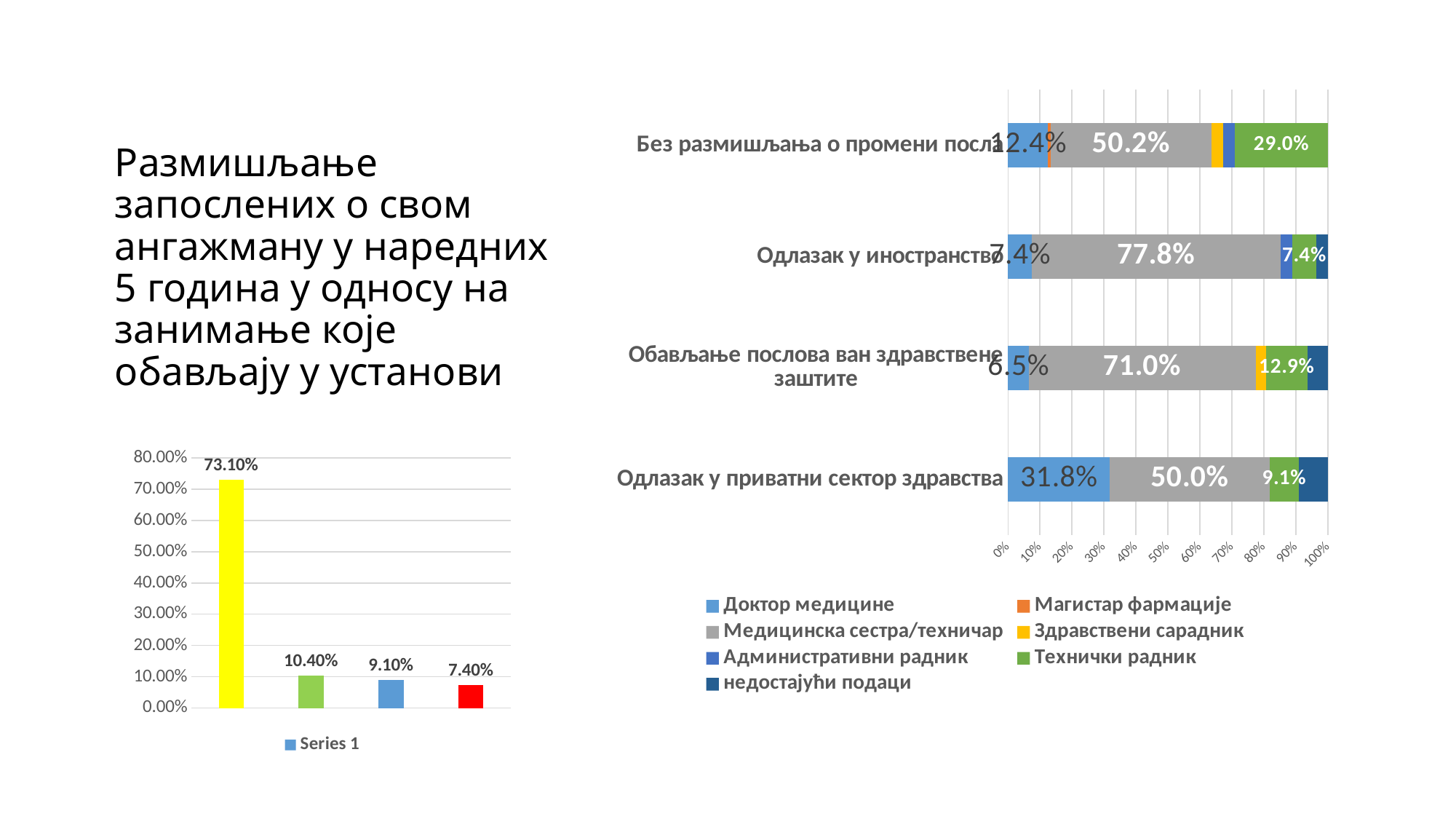
In the right stacked chart, what is the share of Доктор медицине for Одлазак у приватни сектор здравства? 31.8% In the right stacked chart, which category has the largest share of Медицинска сестра/техничар? Одлазак у иностранство In the right stacked chart, what is the share of Технички радник for Без размишљања о промени посла? 29.0% In the right stacked chart, is the Доктор медицине share larger for Одлазак у приватни сектор здравства or for Одлазак у иностранство? Одлазак у приватни сектор здравства In the right stacked chart, how many categories are shown on the vertical axis? 4 In the left chart, what is the value of the red bar? 7.40% In the right stacked chart, how many series does the legend list? 7 In the left chart, what series name does the legend show? Series 1 In the right stacked chart, what is the share of Медицинска сестра/техничар for Одлазак у иностранство? 77.8% In the left chart, how many bars are plotted? 4 In the left chart, what is the difference between the highest and lowest bar values? 65.70% In the left chart, what is the value of the tallest (yellow) bar? 73.10%